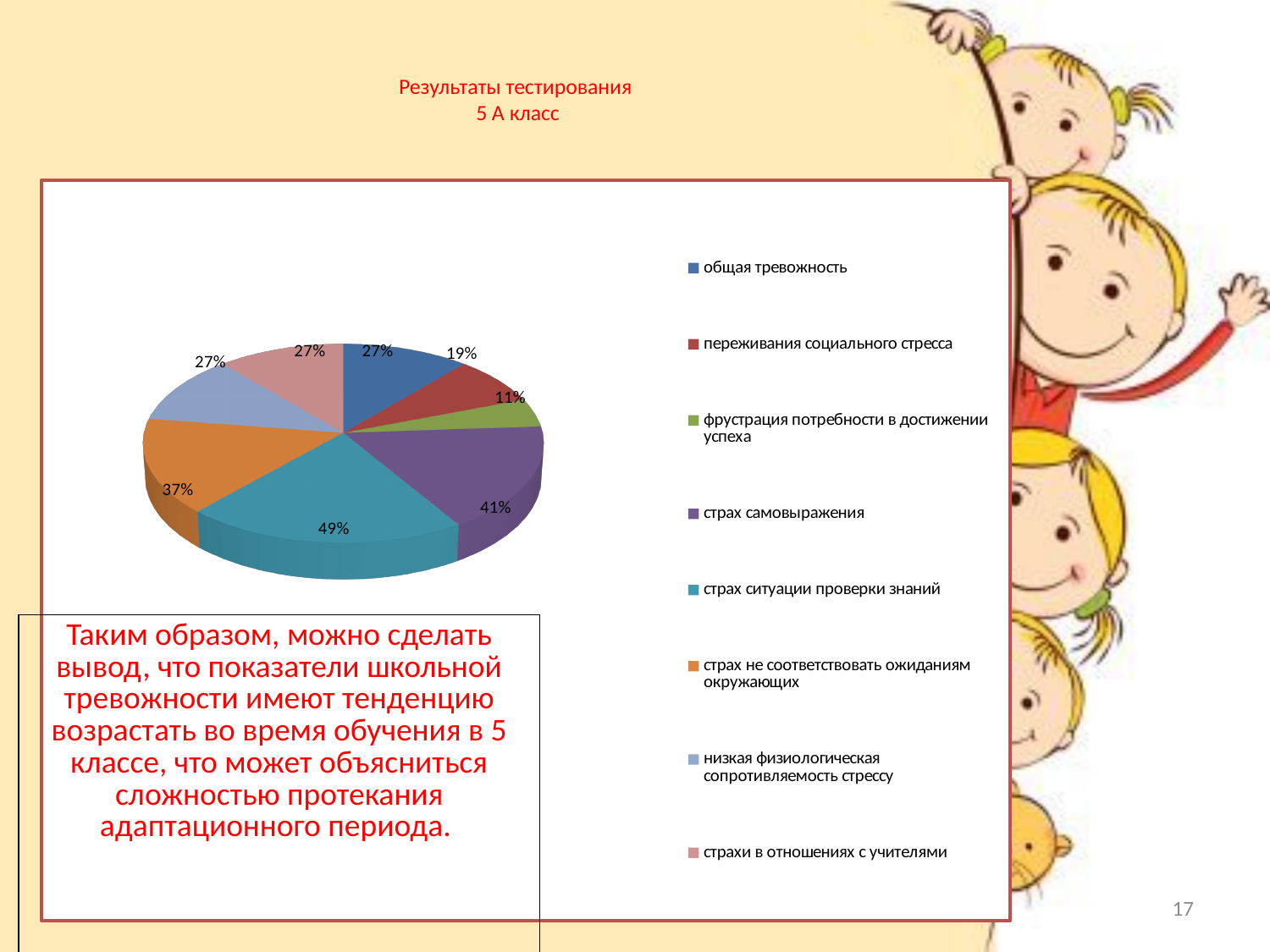
What value is shown for "фрустрация потребности в достижении успеха"? 11% Which category has the lowest value in the pie chart? фрустрация потребности в достижении успеха What kind of chart is shown on the slide? Pie chart What value is shown for "страх самовыражения"? 41% Which category has the highest value in the pie chart? страх ситуации проверки знаний What value is shown for "страх ситуации проверки знаний"? 49% What is the difference between the values for "страх ситуации проверки знаний" and "страх самовыражения"? 8% How many entries does the legend of the pie chart list? 8 What value is shown for "страх не соответствовать ожиданиям окружающих"? 37% Which is larger: the value for "страх не соответствовать ожиданиям окружающих" or the value for "общая тревожность"? страх не соответствовать ожиданиям окружающих How many slices does the pie chart have? 8 What value is shown for "переживания социального стресса"? 19%